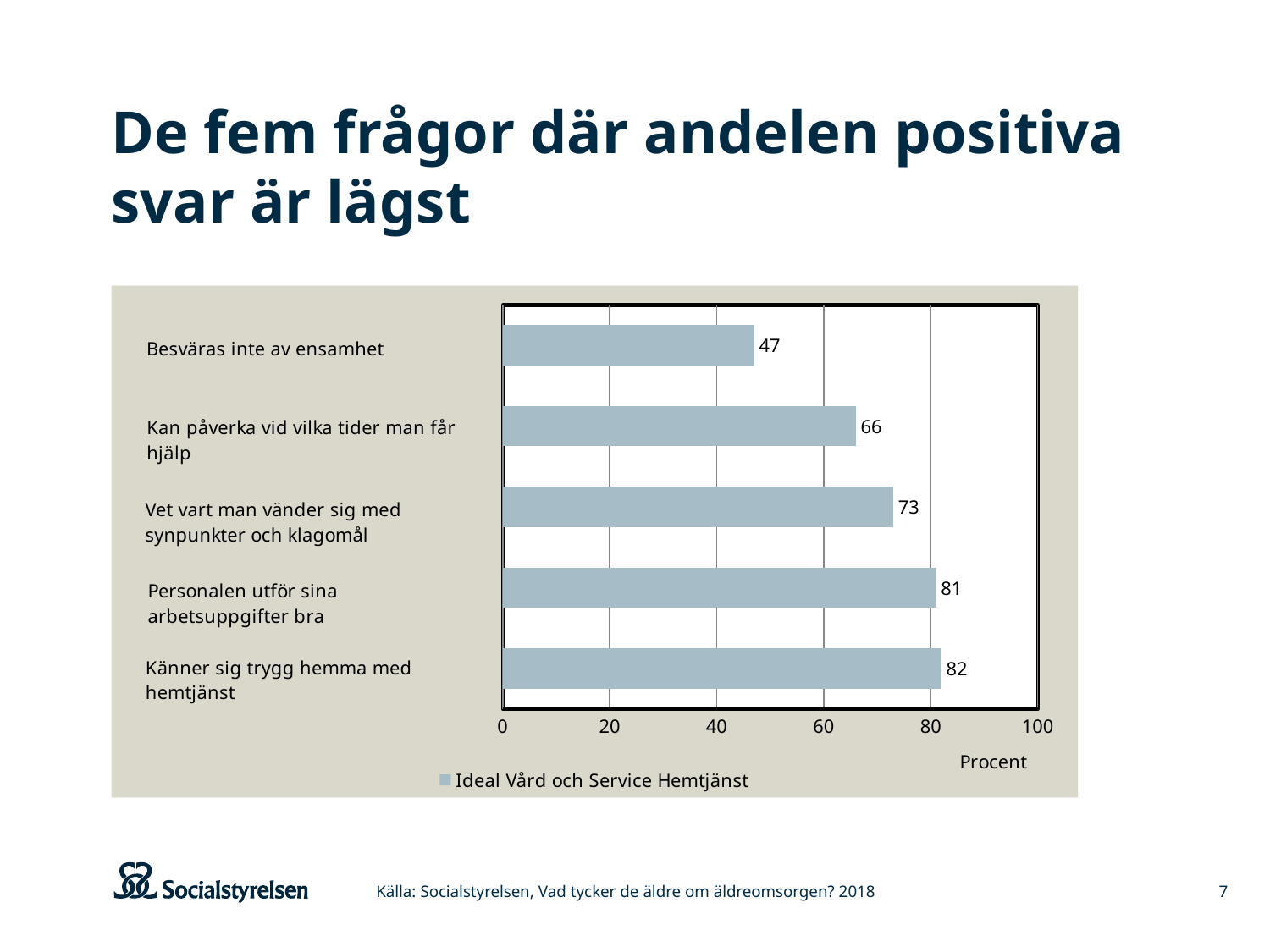
What kind of chart is shown on the slide? Bar chart What is the value for "Besväras inte av ensamhet"? 47 Which category has the highest value? Känner sig trygg hemma med hemtjänst What is the value for "Personalen utför sina arbetsuppgifter bra"? 81 What is the value for "Känner sig trygg hemma med hemtjänst"? 82 Which is larger, the value for "Kan påverka vid vilka tider man får hjälp" or the value for "Vet vart man vänder sig med synpunkter och klagomål"? Vet vart man vänder sig med synpunkter och klagomål What is the value for "Kan påverka vid vilka tider man får hjälp"? 66 What is the value for "Vet vart man vänder sig med synpunkter och klagomål"? 73 How many categories are shown in the chart? 5 What is the difference between the values for "Vet vart man vänder sig med synpunkter och klagomål" and "Besväras inte av ensamhet"? 26 Which category has the lowest value? Besväras inte av ensamhet What series name does the legend show? Ideal Vård och Service Hemtjänst